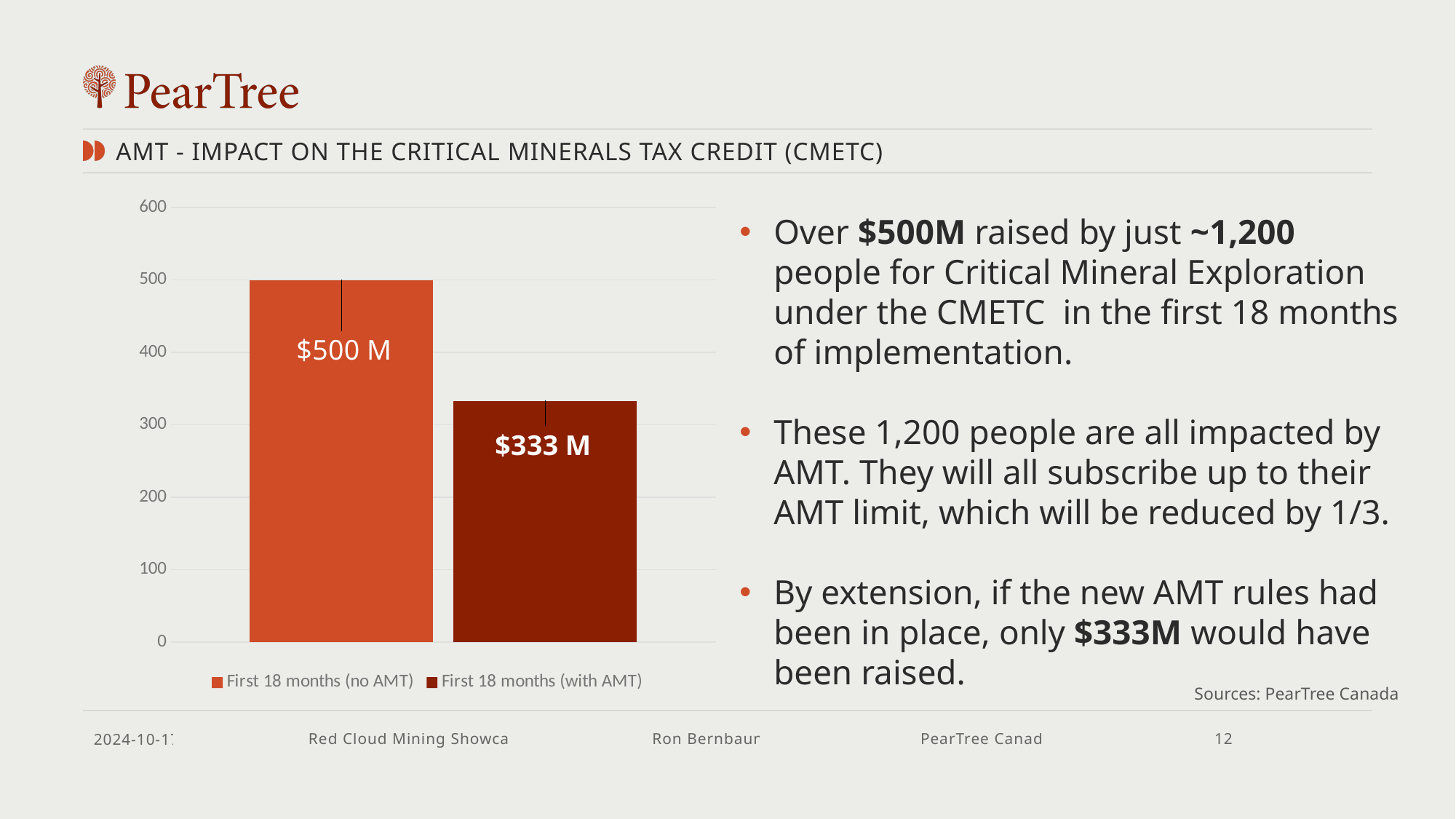
How many bars are plotted in the chart? 2 What is the value for First 18 months (no AMT)? $500 M What is the highest value shown on the vertical axis? 600 What is the difference between the First 18 months (no AMT) value and the First 18 months (with AMT) value? $167 M Which series has the lowest value? First 18 months (with AMT) Is the value for First 18 months (no AMT) greater or less than 400? greater What kind of chart is shown on the slide? bar chart Is the value for First 18 months (with AMT) greater or less than 400? less What is the title of the slide containing the chart? AMT - IMPACT ON THE CRITICAL MINERALS TAX CREDIT (CMETC) Which series has the higher value, First 18 months (no AMT) or First 18 months (with AMT)? First 18 months (no AMT) How many series does the legend list? 2 What is the value for First 18 months (with AMT)? $333 M